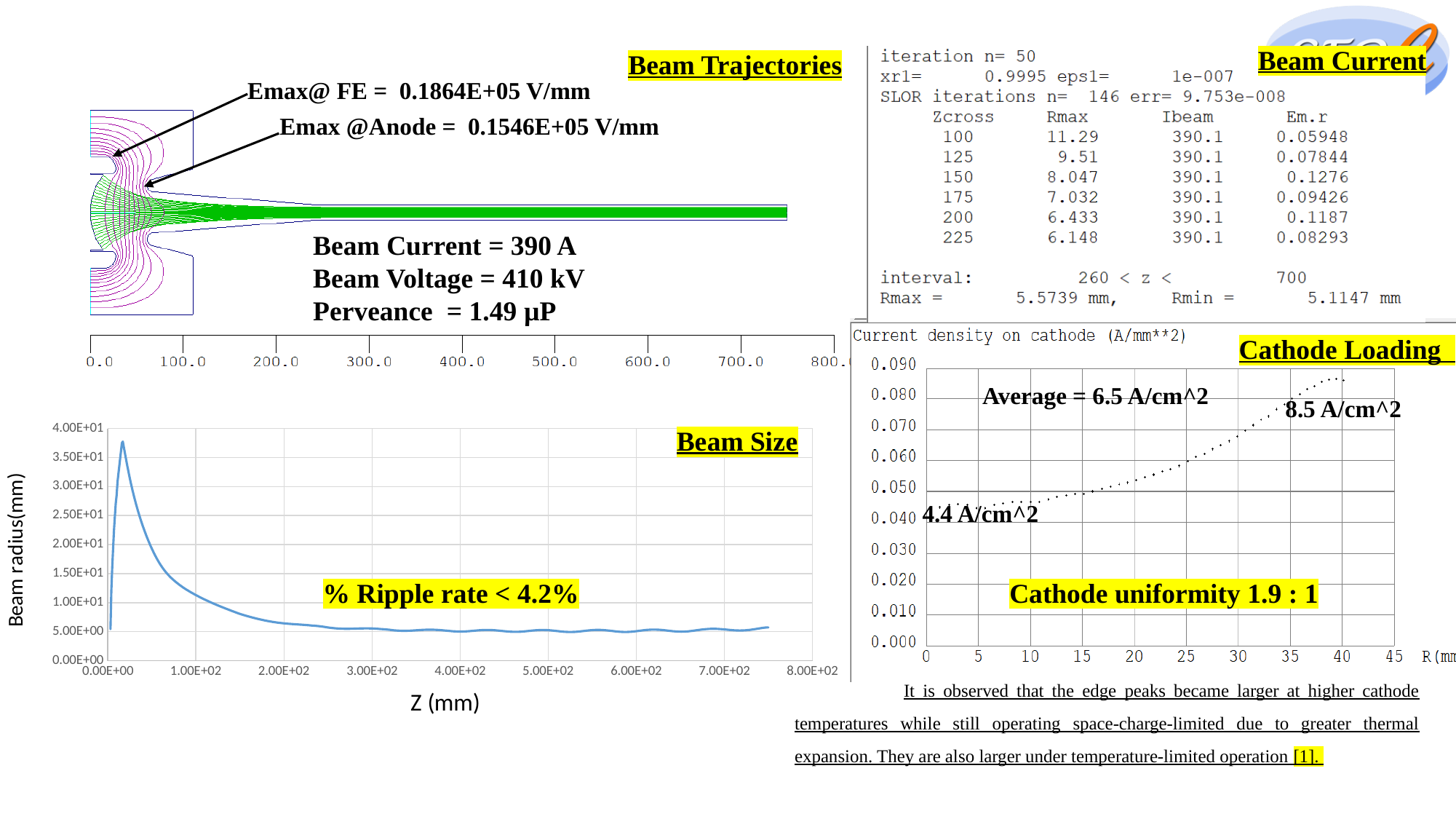
In the Cathode Loading chart, is the current density at R = 5 greater or less than 0.050? less In the Cathode Loading chart, what current density is annotated at the outer edge of the cathode? 8.5 A/cm^2 In the Beam Size chart, what is the label of the y axis? Beam radius(mm) In the Beam Size chart, is the peak beam radius greater or less than 3.50E+01? greater In the Cathode Loading chart, is the current density at R = 40 greater or less than 0.080? greater In the Beam Size chart, what is the label of the x axis? Z (mm) In the Cathode Loading chart, what current density is annotated near the cathode centre? 4.4 A/cm^2 In the Cathode Loading chart, does the current density rise or fall as R increases? rise What kind of chart is the Beam Size chart? line chart In the Cathode Loading chart, what average current density is annotated? 6.5 A/cm^2 In the Beam Size chart, does the beam radius rise or fall along the x axis after its early peak? fall